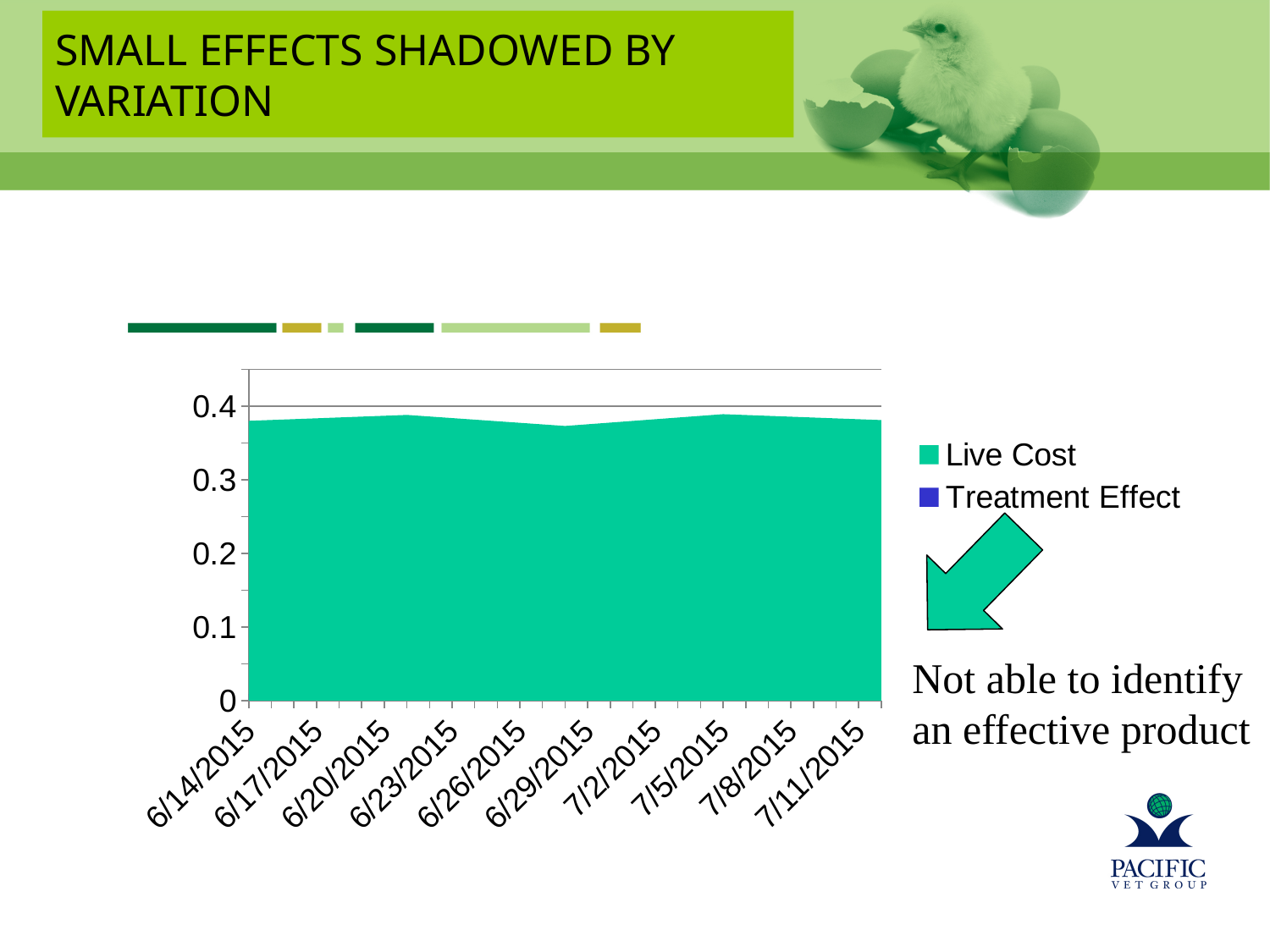
How many date labels are shown along the x axis of the chart? 10 What is the first date label on the x axis of the chart? 6/14/2015 What is the highest value shown on the y axis of the chart? 0.4 Is the Live Cost value for 7/11/2015 greater or less than 0.2? greater Is the Live Cost value for 7/5/2015 greater or less than 0.4? less Is the Live Cost value for 6/14/2015 greater or less than 0.4? less How many series does the chart legend list? 2 What are the two series named in the chart legend? Live Cost and Treatment Effect What kind of chart is shown on the slide? area chart Do the Live Cost values rise sharply, fall sharply, or stay roughly flat across the dates on the x axis? stay roughly flat